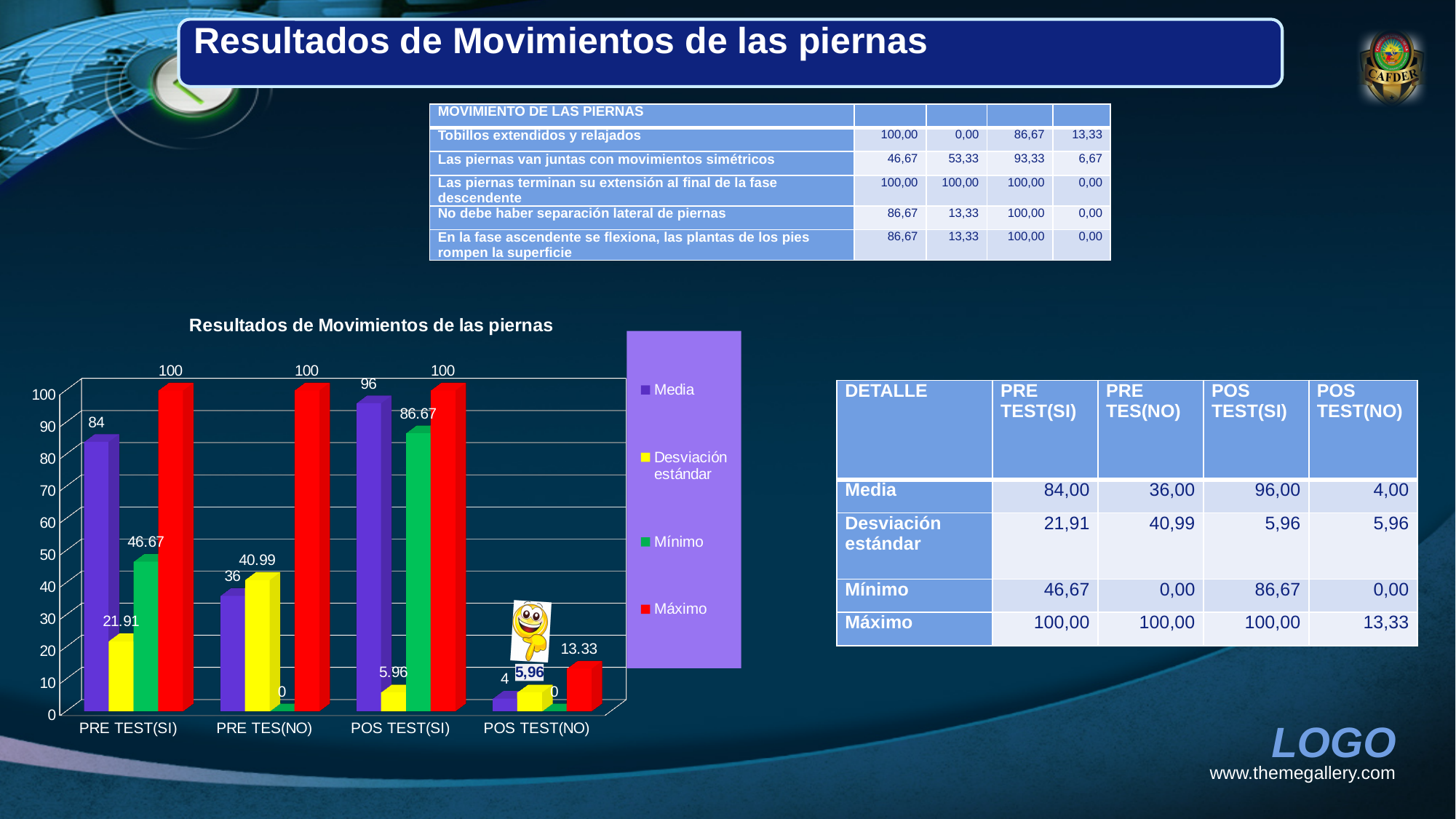
What is the difference between the Media values for POS TEST(SI) and PRE TEST(SI)? 12 What is the Mínimo value for POS TEST(SI)? 86.67 What is the Desviación estándar value for PRE TES(NO)? 40.99 Which category has the highest Media value? POS TEST(SI) How many series does the legend list? 4 Which is larger, the Desviación estándar for PRE TEST(SI) or for PRE TES(NO)? PRE TES(NO) What is the Máximo value for POS TEST(NO)? 13.33 Which colour represents the Máximo series? Red What kind of chart is shown? Bar chart Which category has the lowest Media value? POS TEST(NO) How many categories are shown on the x axis? 4 What is the Media value for PRE TEST(SI)? 84